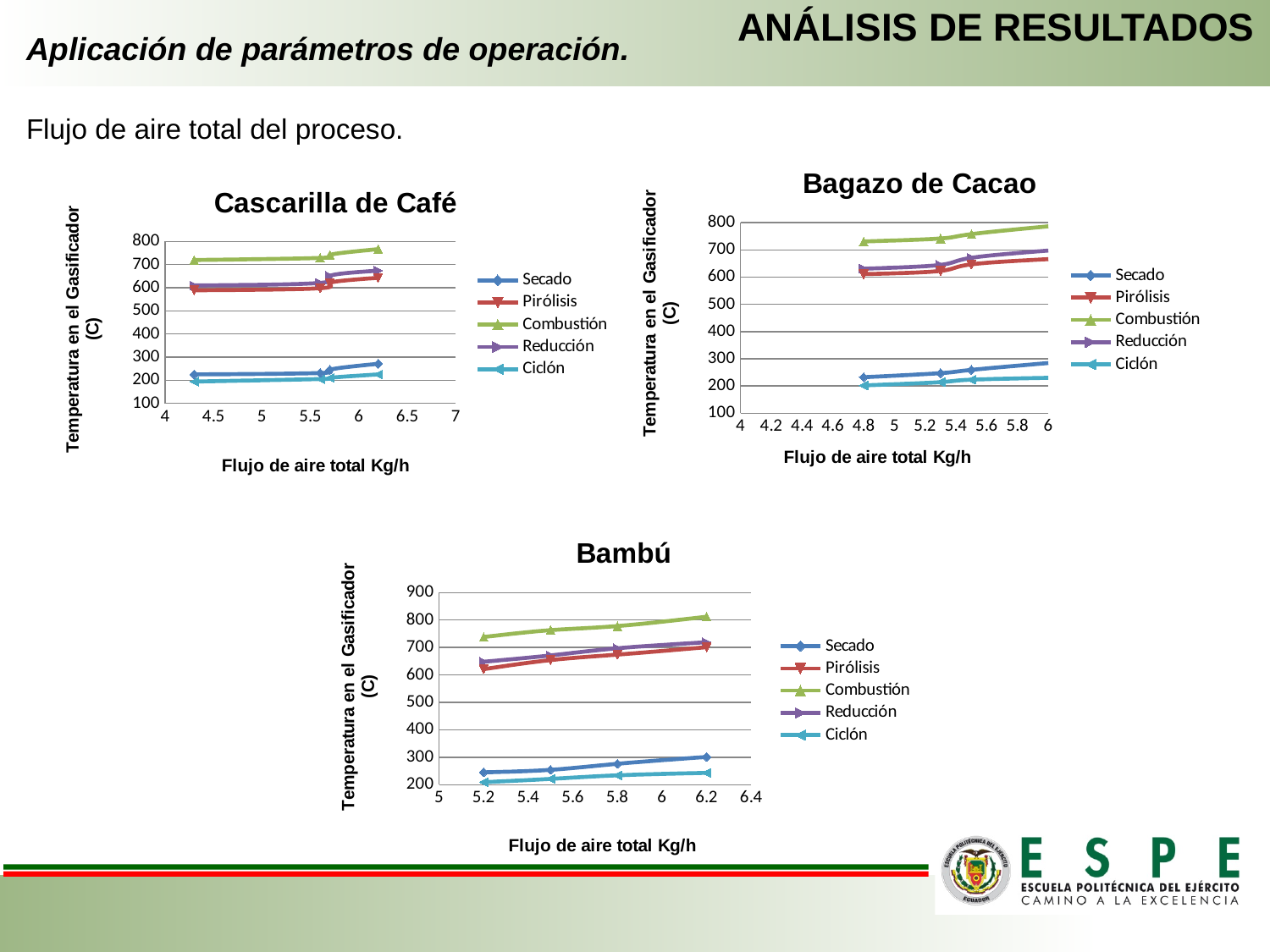
What is the title of the chart at the bottom of the slide? Bambú In the 'Bambú' chart, does the Combustión temperature rise or fall as the air flow increases? rises In the 'Bagazo de Cacao' chart, which series is higher, Combustión or Secado? Combustión In the 'Cascarilla de Café' chart, is the Ciclón temperature at 6.2 Kg/h greater or less than 300? less In the 'Bambú' chart, which series has the lowest temperatures? Ciclón How many series does the legend of the 'Bagazo de Cacao' chart list? 5 In the 'Cascarilla de Café' chart, which series has the highest temperatures? Combustión How many data points does each series in the 'Bambú' chart have? 4 What is the x-axis label of the 'Bagazo de Cacao' chart? Flujo de aire total Kg/h In the 'Bambú' chart, is the Combustión temperature at 6.2 Kg/h greater or less than 700? greater What kind of chart is the 'Cascarilla de Café' chart? line chart In the 'Bagazo de Cacao' chart, is the Combustión temperature at 4.8 Kg/h greater or less than 700? greater